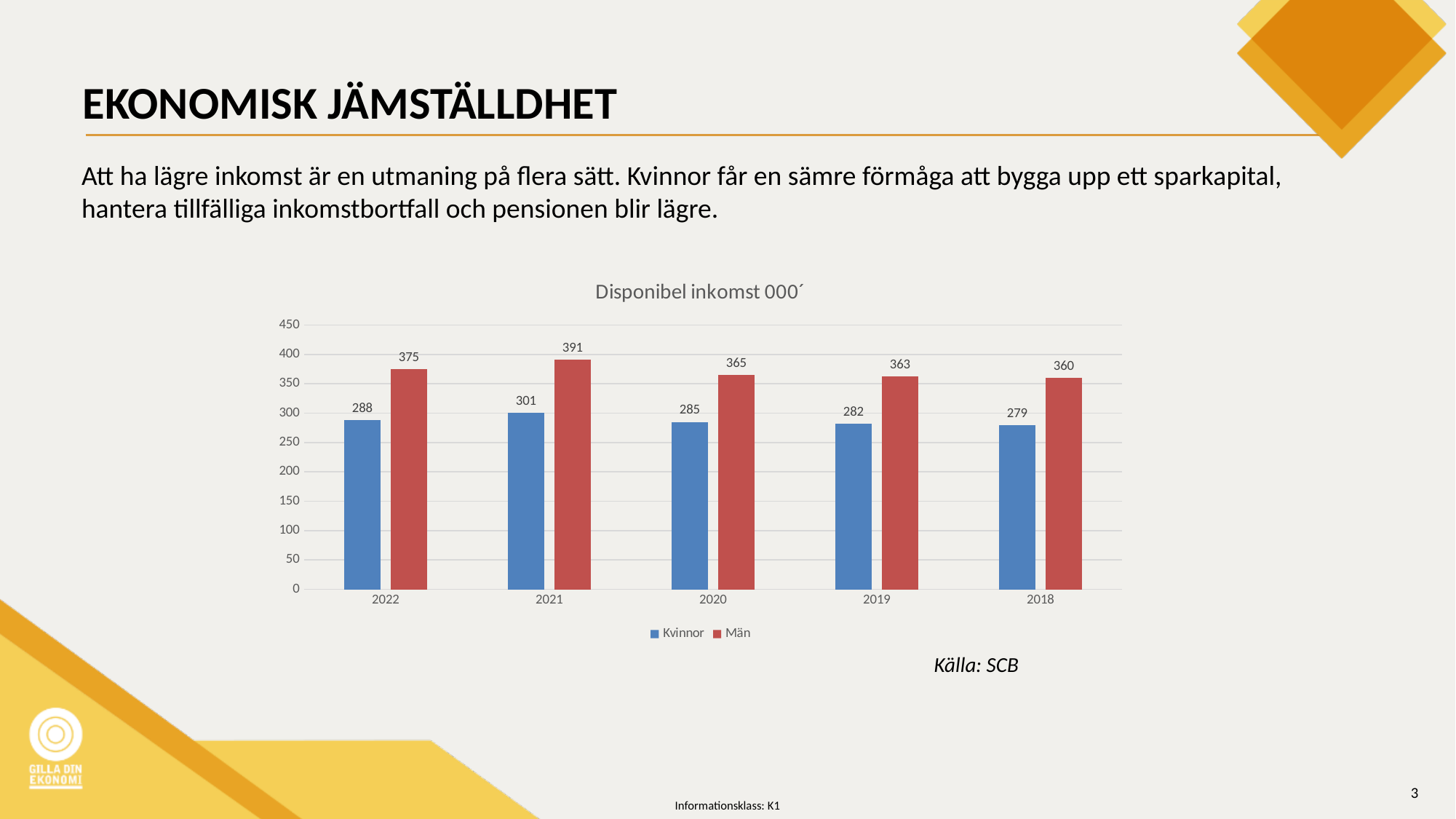
What is the difference between Män and Kvinnor in 2021? 90 In which year is the value for Kvinnor lowest? 2018 Which is larger in 2019, the value for Kvinnor or the value for Män? Män How many series does the legend list? 2 How many years are shown on the x axis? 5 What kind of chart is shown on the slide? bar chart What is the value for Kvinnor in 2018? 279 In which year is the value for Män highest? 2021 What is the difference between Män and Kvinnor in 2020? 80 What is the value for Män in 2021? 391 Is the value for Män in 2018 greater or less than 300? greater What is the value for Kvinnor in 2022? 288